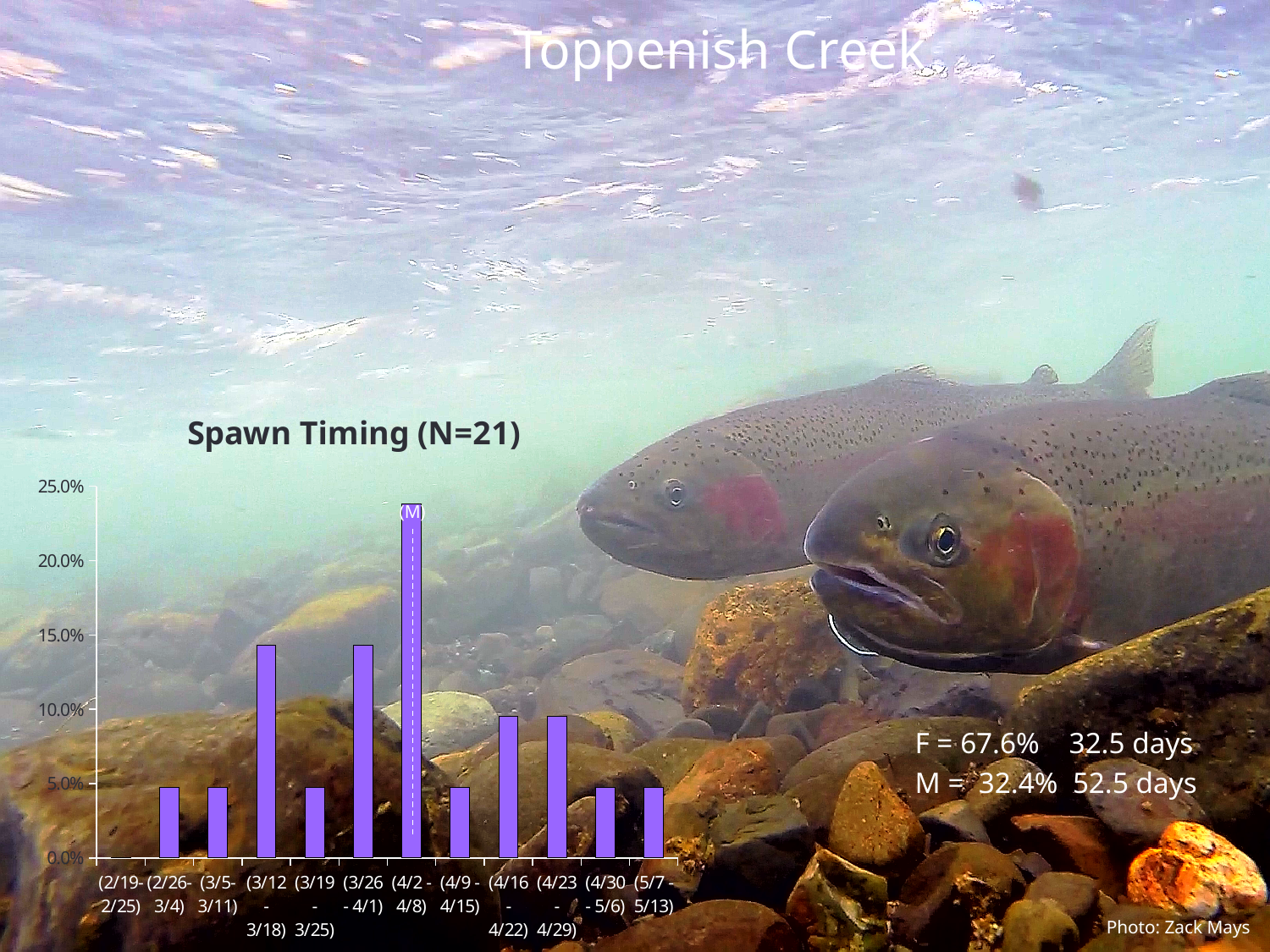
What type of chart is shown on the slide? bar chart Is the value for the week (4/16 - 4/22) greater or less than 10.0%? less What label is printed at the top of the tallest bar in the chart? (M) Which is larger, the value for (4/2 - 4/8) or the value for (3/26 - 4/1)? (4/2 - 4/8) Which is larger, the value for (3/12 - 3/18) or the value for (4/16 - 4/22)? (3/12 - 3/18) Which week has the highest spawn timing percentage? (4/2 - 4/8) How many weekly categories are shown on the x axis of the chart? 12 What is the title of the chart? Spawn Timing (N=21) Which week has no bar (the lowest value) in the chart? (2/19-2/25) Is the value for the week (4/2 - 4/8) greater or less than 20.0%? greater Is the value for the week (3/12 - 3/18) greater or less than 15.0%? less